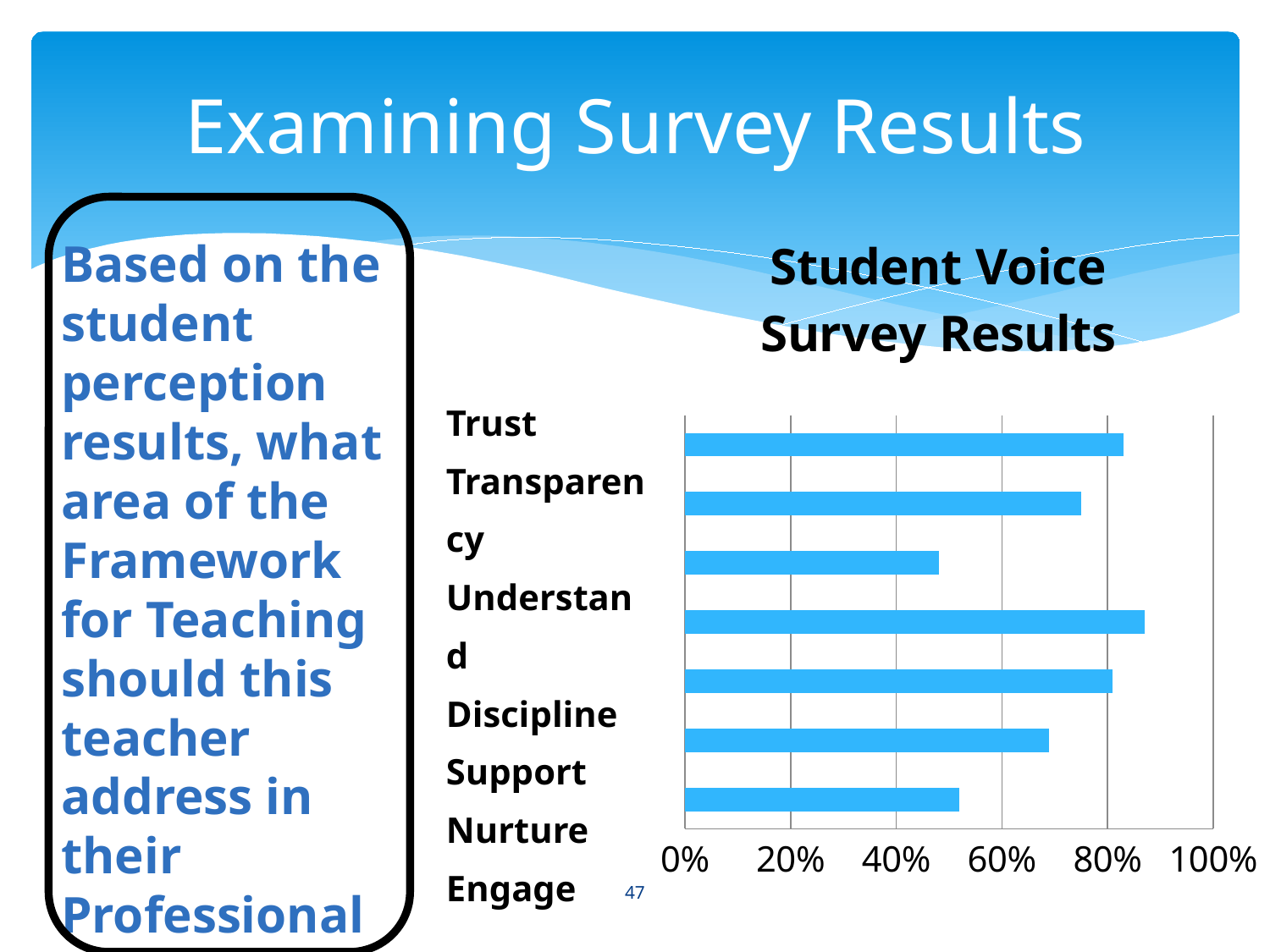
Is the value for Discipline greater or less than 80%? greater How many categories are plotted in the chart? 7 What is the maximum value shown on the horizontal axis? 100% Which is larger, the value for Trust or the value for Understand? Trust Is the value for Nurture greater or less than 60%? greater Which category has the lowest value in the chart? Understand Is the value for Engage greater or less than 60%? less What type of chart is shown on the slide? bar chart What is the title of the chart? Student Voice Survey Results Which category has the highest value in the chart? Discipline